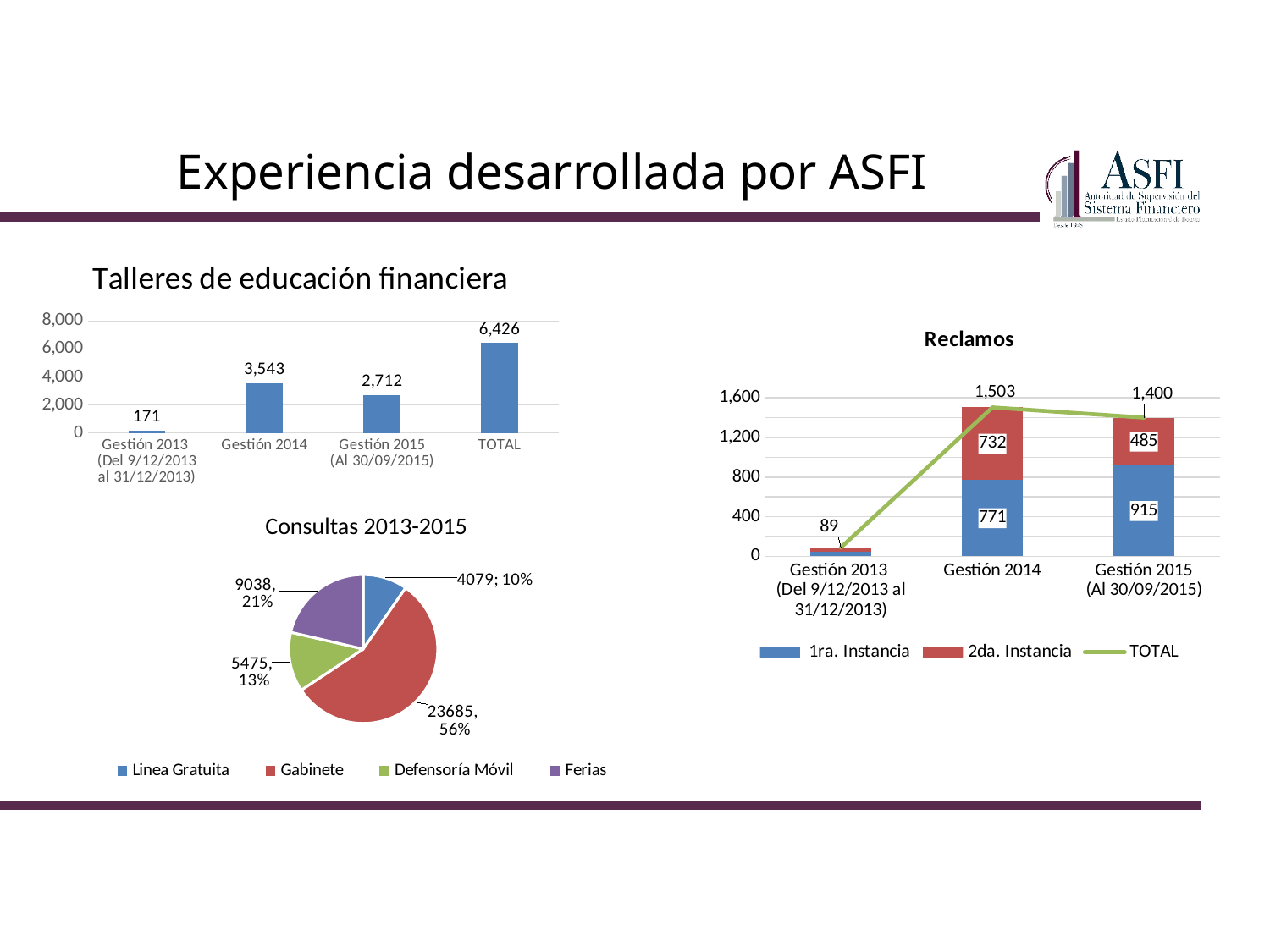
In the 'Talleres de educación financiera' chart, which category has the lowest value? Gestión 2013 In the 'Reclamos' chart, which is larger: 2da. Instancia for Gestión 2014 or 2da. Instancia for Gestión 2015? Gestión 2014 What kind of chart is 'Consultas 2013-2015'? Pie chart In the 'Consultas 2013-2015' pie chart, what share does Gabinete have? 56% In the 'Consultas 2013-2015' pie chart, what is the value for Ferias? 9038 In the 'Reclamos' chart, what is the total of the stacked bar for Gestión 2014? 1,503 How many categories does the legend of the 'Consultas 2013-2015' pie chart list? 4 In the 'Talleres de educación financiera' chart, what is the value for Gestión 2015? 2,712 In the 'Talleres de educación financiera' chart, what is the difference between Gestión 2014 and Gestión 2015? 831 How many series does the legend of the 'Reclamos' chart list? 3 In the 'Reclamos' chart, what is the 1ra. Instancia value for Gestión 2015? 915 In the 'Talleres de educación financiera' chart, what is the value for Gestión 2014? 3,543